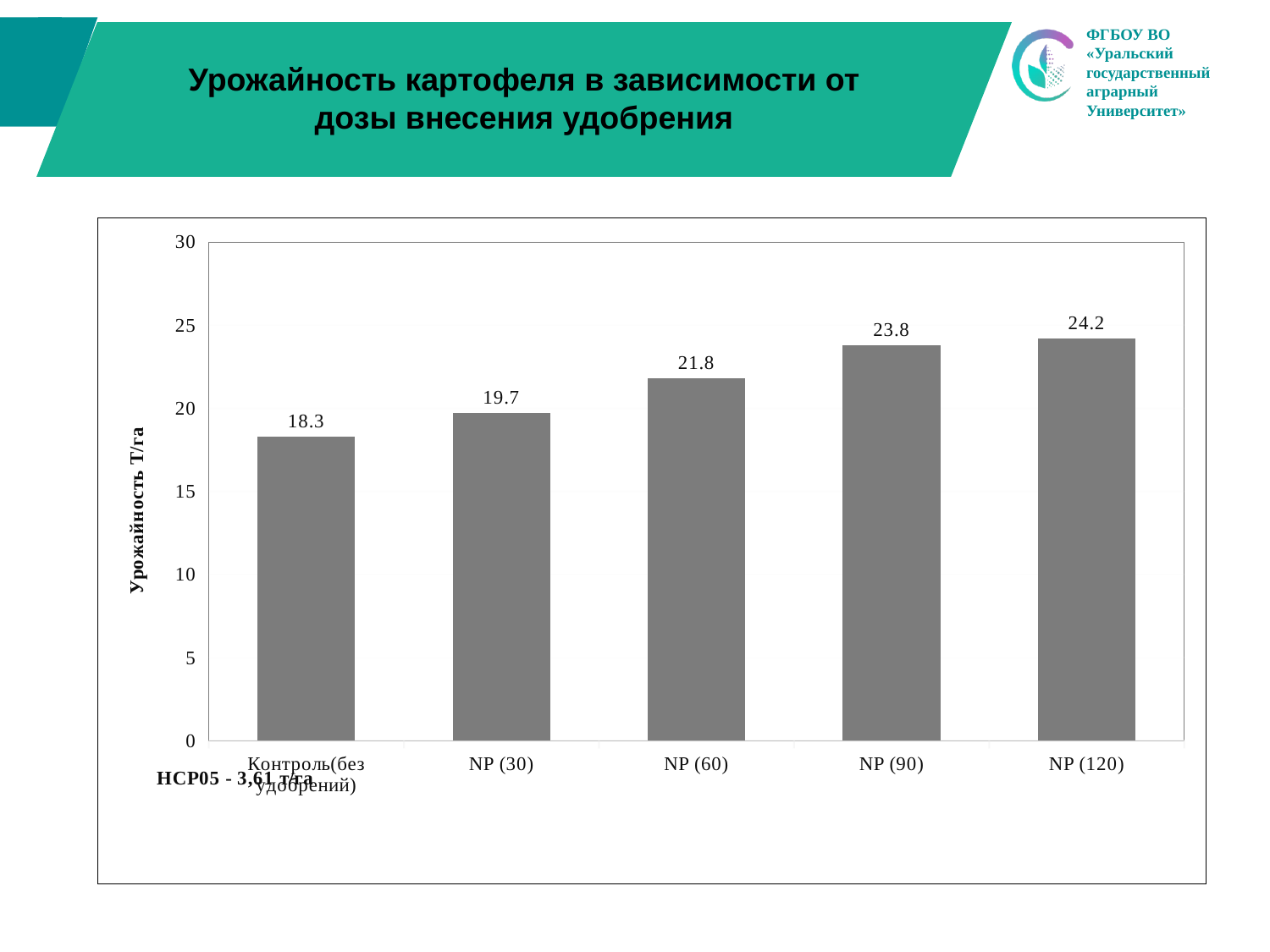
What is the difference between the yield for NP (90) and NP (30)? 4.1 Which category has the highest yield? NP (120) How many categories are shown on the x axis? 5 What is the yield value for NP (120)? 24.2 Is the value for NP (90) greater or less than 20? greater What is the yield value for the control (Контроль (без удобрений)) bar? 18.3 What is the label of the vertical axis? Урожайность Т/га Which is larger, the yield for NP (60) or NP (30)? NP (60) Do the yield values rise or fall from left to right along the x axis? rise Which category has the lowest yield? Контроль (без удобрений) What is the yield value for NP (60)? 21.8 What kind of chart is shown on the slide? bar chart